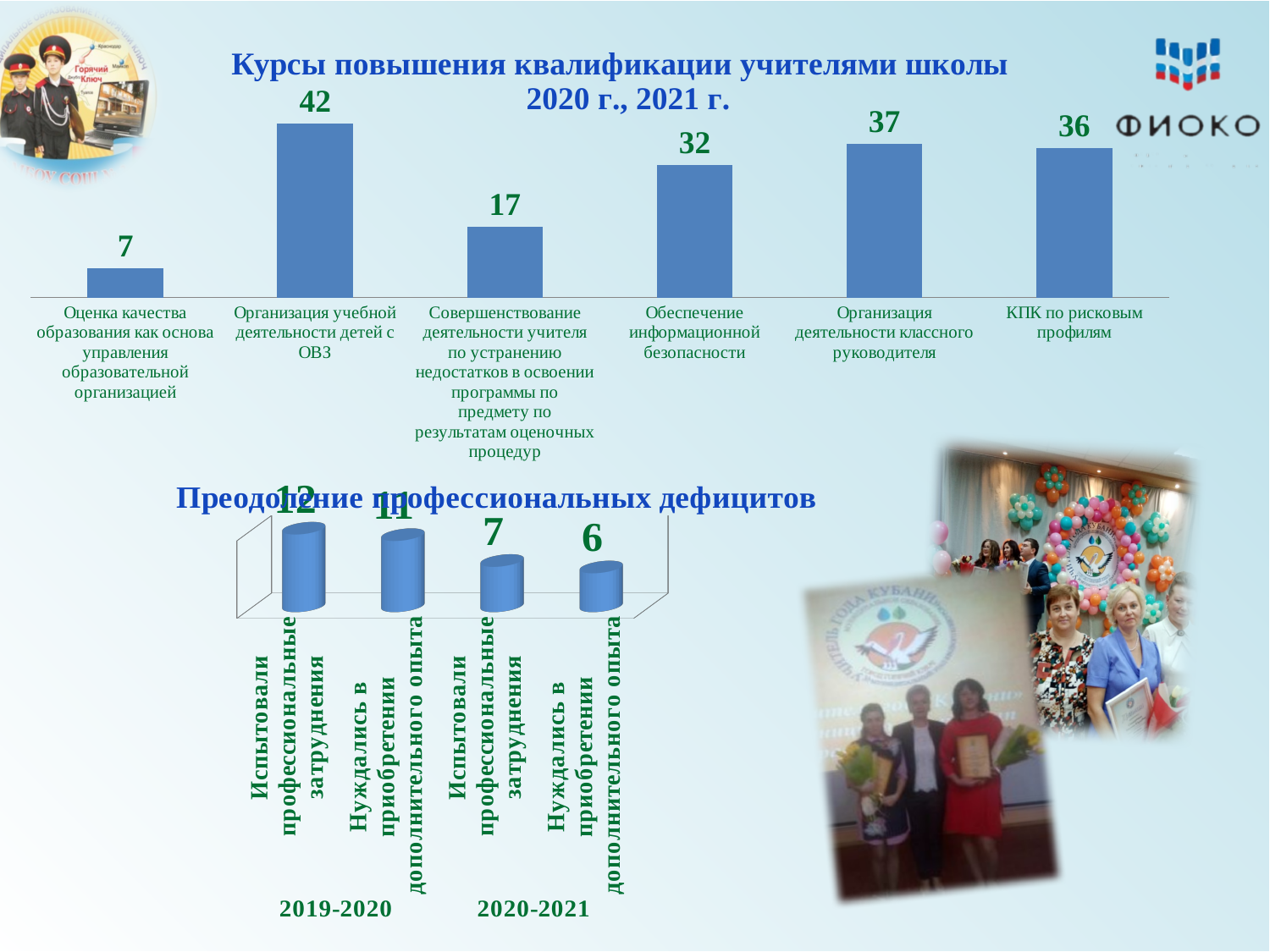
In the top chart 'Курсы повышения квалификации учителями школы 2020 г., 2021 г.', which category has the lowest value? Оценка качества образования как основа управления образовательной организацией In the bottom chart 'Преодоление профессиональных дефицитов', what is the value for 'Нуждались в приобретении дополнительного опыта' in 2020-2021? 6 In the top chart 'Курсы повышения квалификации учителями школы 2020 г., 2021 г.', which category has the highest value? Организация учебной деятельности детей с ОВЗ In the top chart 'Курсы повышения квалификации учителями школы 2020 г., 2021 г.', what is the value for 'Обеспечение информационной безопасности'? 32 In the top chart 'Курсы повышения квалификации учителями школы 2020 г., 2021 г.', what is the difference between 'Организация деятельности классного руководителя' and 'КПК по рисковым профилям'? 1 In the top chart 'Курсы повышения квалификации учителями школы 2020 г., 2021 г.', how many categories are shown? 6 In the top chart 'Курсы повышения квалификации учителями школы 2020 г., 2021 г.', what is the value for 'Организация учебной деятельности детей с ОВЗ'? 42 In the top chart 'Курсы повышения квалификации учителями школы 2020 г., 2021 г.', which is larger: 'Совершенствование деятельности учителя по устранению недостатков...' or 'Обеспечение информационной безопасности'? Обеспечение информационной безопасности In the bottom chart 'Преодоление профессиональных дефицитов', what is the value for 'Испытывали профессиональные затруднения' in 2019-2020? 12 What kind of chart is the top chart 'Курсы повышения квалификации учителями школы 2020 г., 2021 г.'? Bar chart In the bottom chart 'Преодоление профессиональных дефицитов', how many bars are shown? 4 In the bottom chart 'Преодоление профессиональных дефицитов', what is the difference between 'Испытывали профессиональные затруднения' in 2019-2020 and in 2020-2021? 5